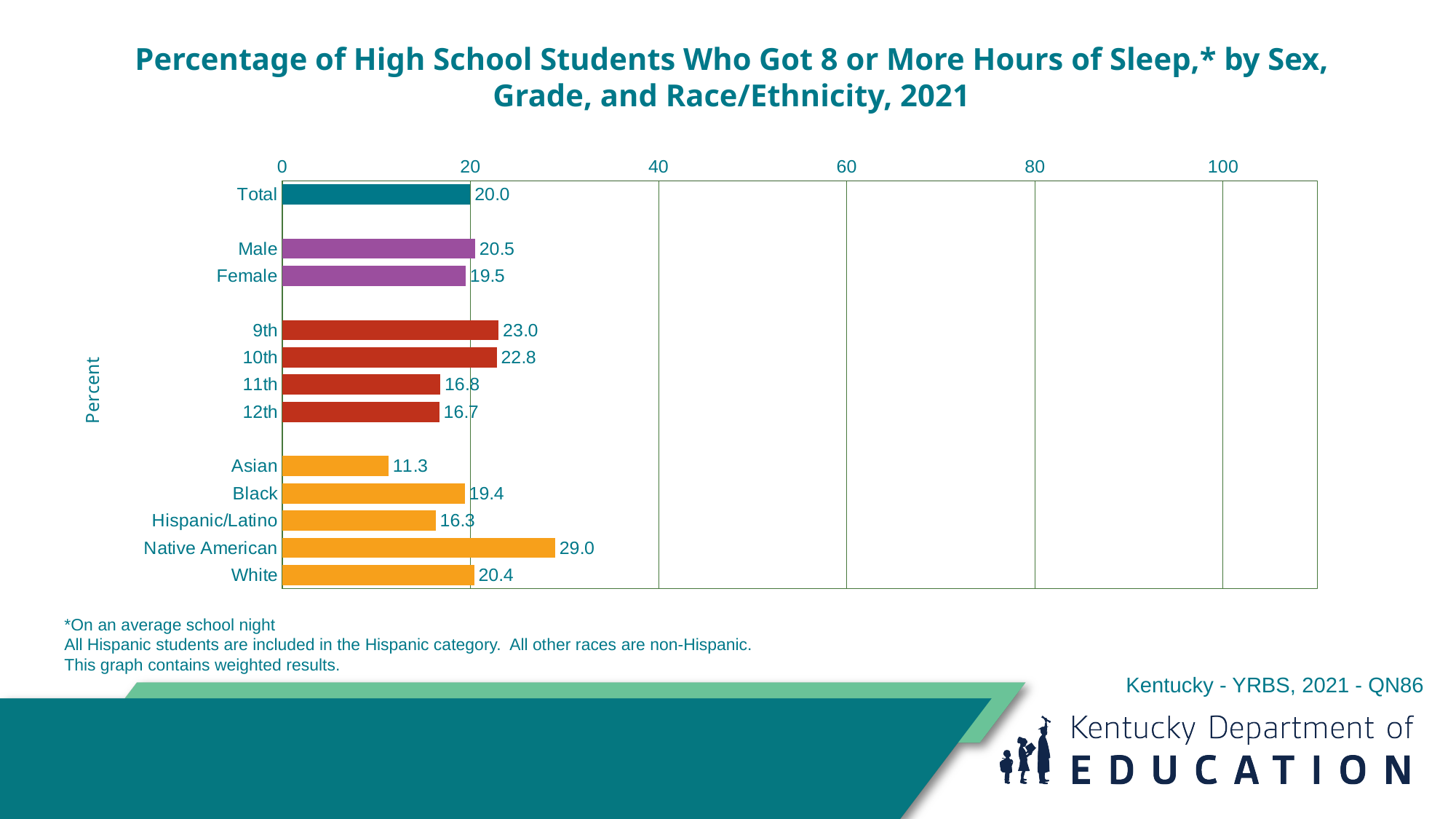
What is the value for Total? 20.0 What is the difference between the 9th grade and 12th grade values? 6.3 What is the difference between the Male and Female values? 1.0 What is the value for Native American? 29.0 Which category has the highest value? Native American Do the values fall or rise from 9th grade to 12th grade? fall Is the value for Native American greater or less than 20? greater Which category has the lowest value? Asian How many categories are plotted on the chart? 12 Which is larger, the value for Black or the value for Hispanic/Latino? Black What kind of chart is shown? bar chart What is the value for 11th grade? 16.8